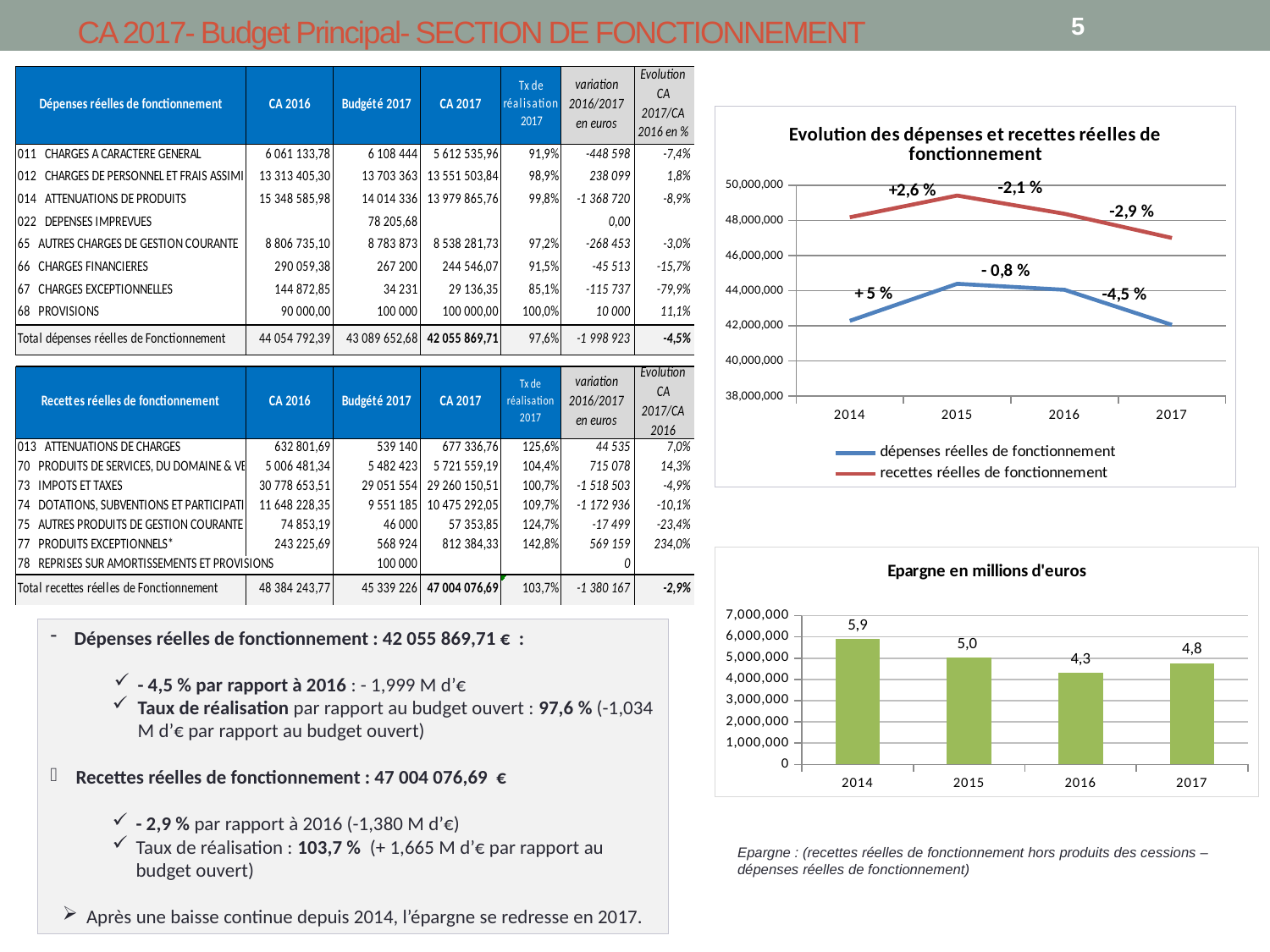
What kind of chart is 'Epargne en millions d'euros'? bar chart In the chart 'Evolution des dépenses et recettes réelles de fonctionnement', which series has the higher value in 2016? recettes réelles de fonctionnement In the chart 'Epargne en millions d'euros', which year has the highest value? 2014 In the chart 'Evolution des dépenses et recettes réelles de fonctionnement', is the value of 'recettes réelles de fonctionnement' for 2015 greater or less than 48,000,000? greater In the chart 'Epargne en millions d'euros', do the values rise or fall from 2014 to 2016? fall In the chart 'Epargne en millions d'euros', which year has the lowest value? 2016 How many series does the legend of the chart 'Evolution des dépenses et recettes réelles de fonctionnement' list? 2 In the chart 'Epargne en millions d'euros', what is the value for 2014? 5,9 In the chart 'Epargne en millions d'euros', how many years are shown on the x axis? 4 In the chart 'Epargne en millions d'euros', what is the difference between the values for 2014 and 2017? 1,1 In the chart 'Evolution des dépenses et recettes réelles de fonctionnement', is the value of 'dépenses réelles de fonctionnement' for 2016 greater or less than 46,000,000? less In the chart 'Epargne en millions d'euros', what is the value for 2016? 4,3